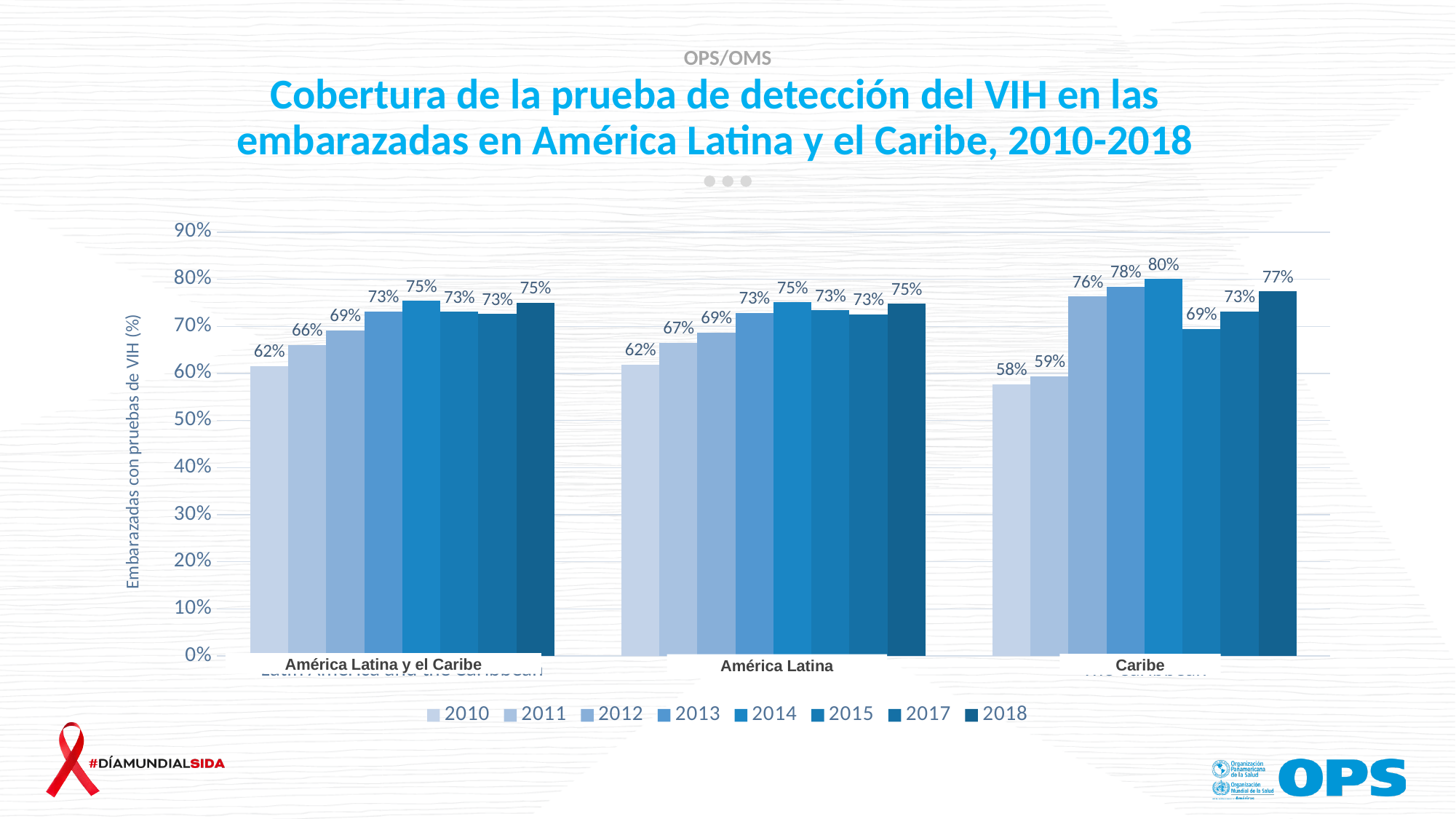
What is the label of the y axis? Embarazadas con pruebas de VIH (%) Which year has the lowest value in the América Latina y el Caribe category? 2010 Which year has the highest value in the Caribe category? 2014 What is the value for 2010 in the Caribe category? 58% What is the value for 2011 in the América Latina category? 67% How many series does the legend list? 8 Which is larger in the Caribe category, the value for 2015 or the value for 2017? 2017 What type of chart is shown on the slide? bar chart What is the value for 2014 in the Caribe category? 80% What is the value for 2018 in the América Latina y el Caribe category? 75% How many categories are shown on the x axis? 3 What is the difference between the 2014 and 2010 values in the Caribe category? 22%